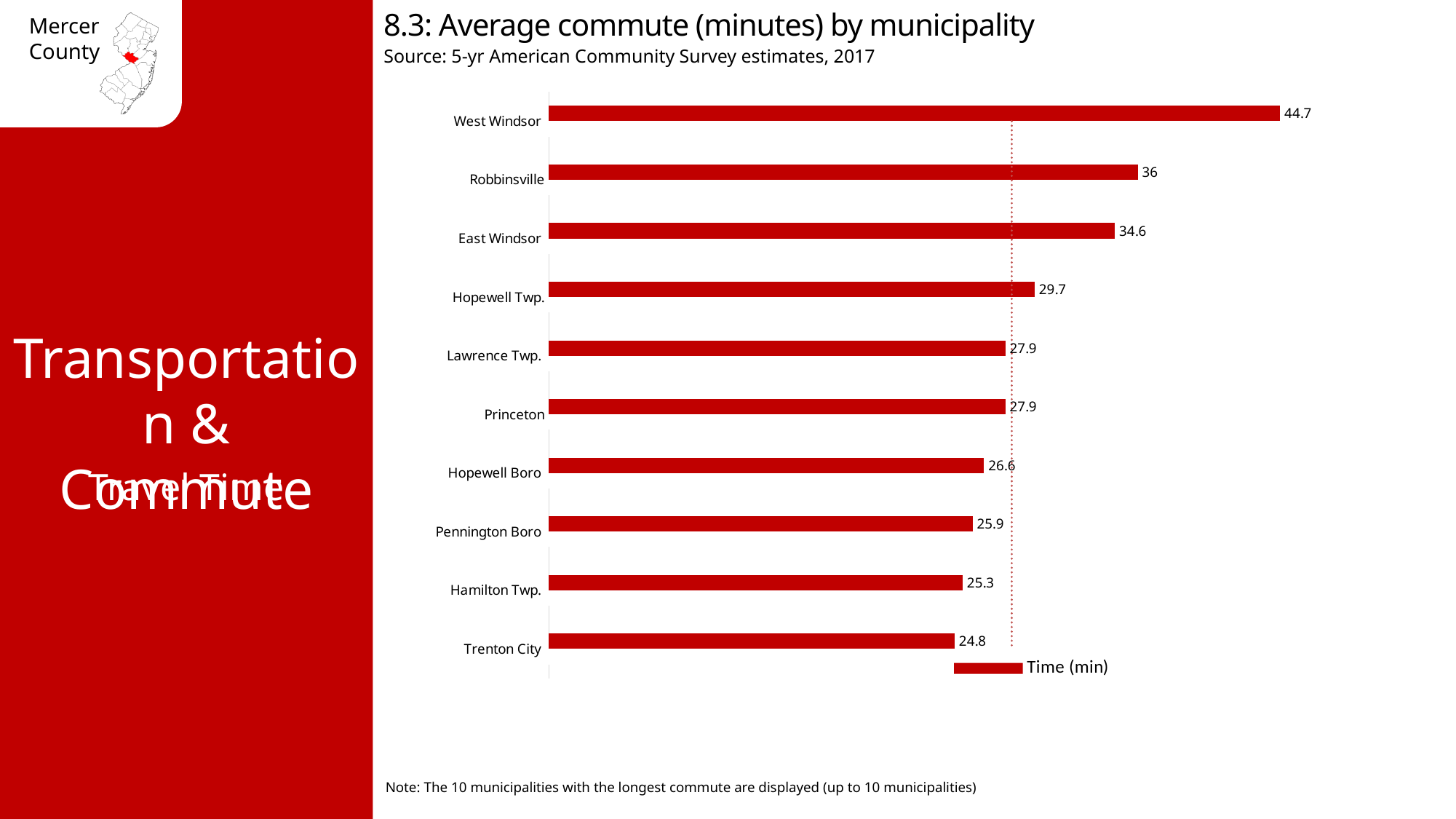
What is the average commute time for West Windsor? 44.7 What type of chart is used on this slide? Bar chart What is the difference in average commute time between West Windsor and Robbinsville? 8.7 Which municipality has the longest average commute? West Windsor What is the average commute time for Hopewell Twp.? 29.7 What is the legend entry for the series shown on the chart? Time (min) What is the average commute time for Pennington Boro? 25.9 What is the difference in average commute time between East Windsor and Hamilton Twp.? 9.3 What is the average commute time for Trenton City? 24.8 Which municipality has the shortest average commute shown on the chart? Trenton City Which has a longer average commute, Robbinsville or East Windsor? Robbinsville How many municipalities are shown on the chart? 10